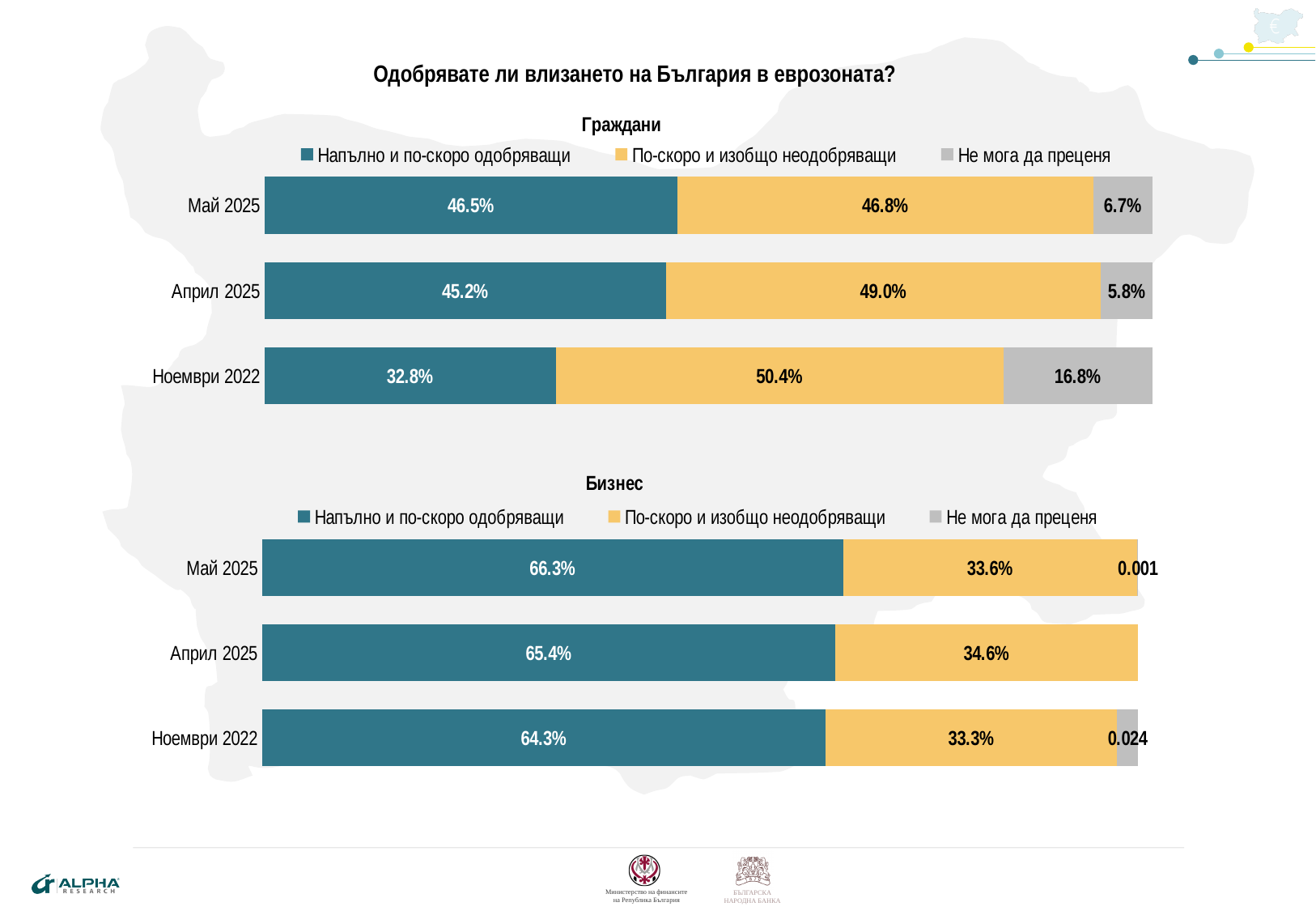
In the 'Бизнес' chart, which period has the highest value for 'Напълно и по-скоро одобряващи'? Май 2025 In the 'Бизнес' chart, what is the value for 'Напълно и по-скоро одобряващи' in Април 2025? 65.4% In the 'Бизнес' chart, what is the value for 'По-скоро и изобщо неодобряващи' in Ноември 2022? 33.3% In the 'Граждани' chart, what is the value for 'Не мога да преценя' in Ноември 2022? 16.8% In the 'Граждани' chart, which period has the highest value for 'По-скоро и изобщо неодобряващи'? Ноември 2022 In the 'Граждани' chart, which period has the lowest value for 'Напълно и по-скоро одобряващи'? Ноември 2022 In the 'Граждани' chart, what is the difference between the 'Напълно и по-скоро одобряващи' values for Май 2025 and Април 2025? 1.3% In the 'Граждани' chart, what is the value for 'Напълно и по-скоро одобряващи' in Май 2025? 46.5% What kind of chart is the 'Граждани' chart? Stacked bar chart In the 'Бизнес' chart, is the 'Напълно и по-скоро одобряващи' value larger in Май 2025 or in Ноември 2022? Май 2025 How many series does the legend of the 'Бизнес' chart list? 3 How many periods are shown in the 'Граждани' chart? 3